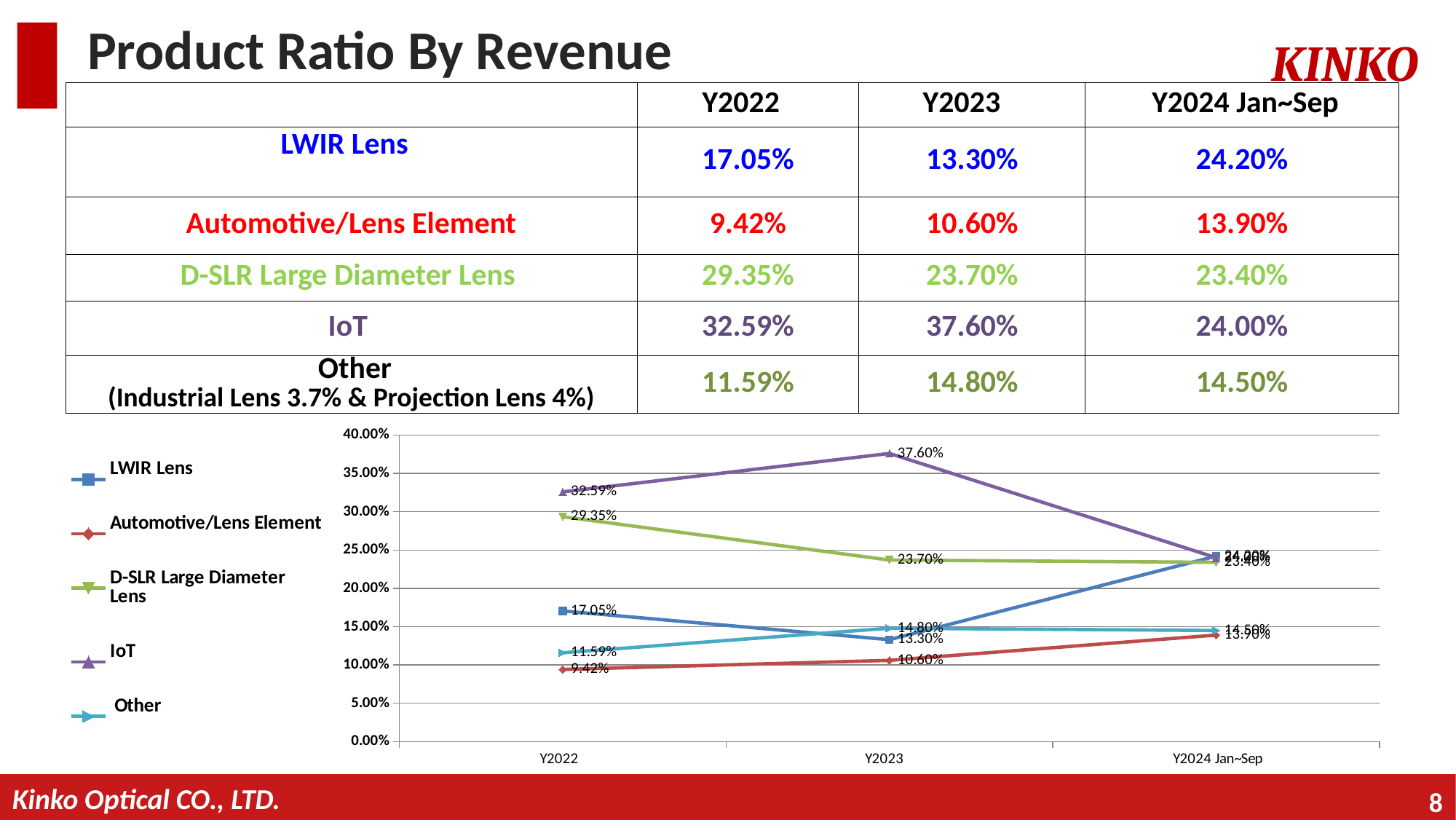
Which series has the highest value in Y2022? IoT What is the value for LWIR Lens in Y2022? 17.05% What is the value for IoT in Y2023? 37.60% How many series does the chart legend list? 5 Which series has the lowest value in Y2023? Automotive/Lens Element What kind of chart is shown on the slide? line chart Does the Automotive/Lens Element series rise or fall from Y2022 to Y2024 Jan~Sep? rise What is the value for Automotive/Lens Element in Y2024 Jan~Sep? 13.90% What is the difference between the IoT value in Y2023 and the IoT value in Y2024 Jan~Sep? 13.60% Which is larger in Y2022: D-SLR Large Diameter Lens or LWIR Lens? D-SLR Large Diameter Lens Does the D-SLR Large Diameter Lens series rise or fall from Y2022 to Y2024 Jan~Sep? fall How many points are plotted along the x axis of the chart? 3